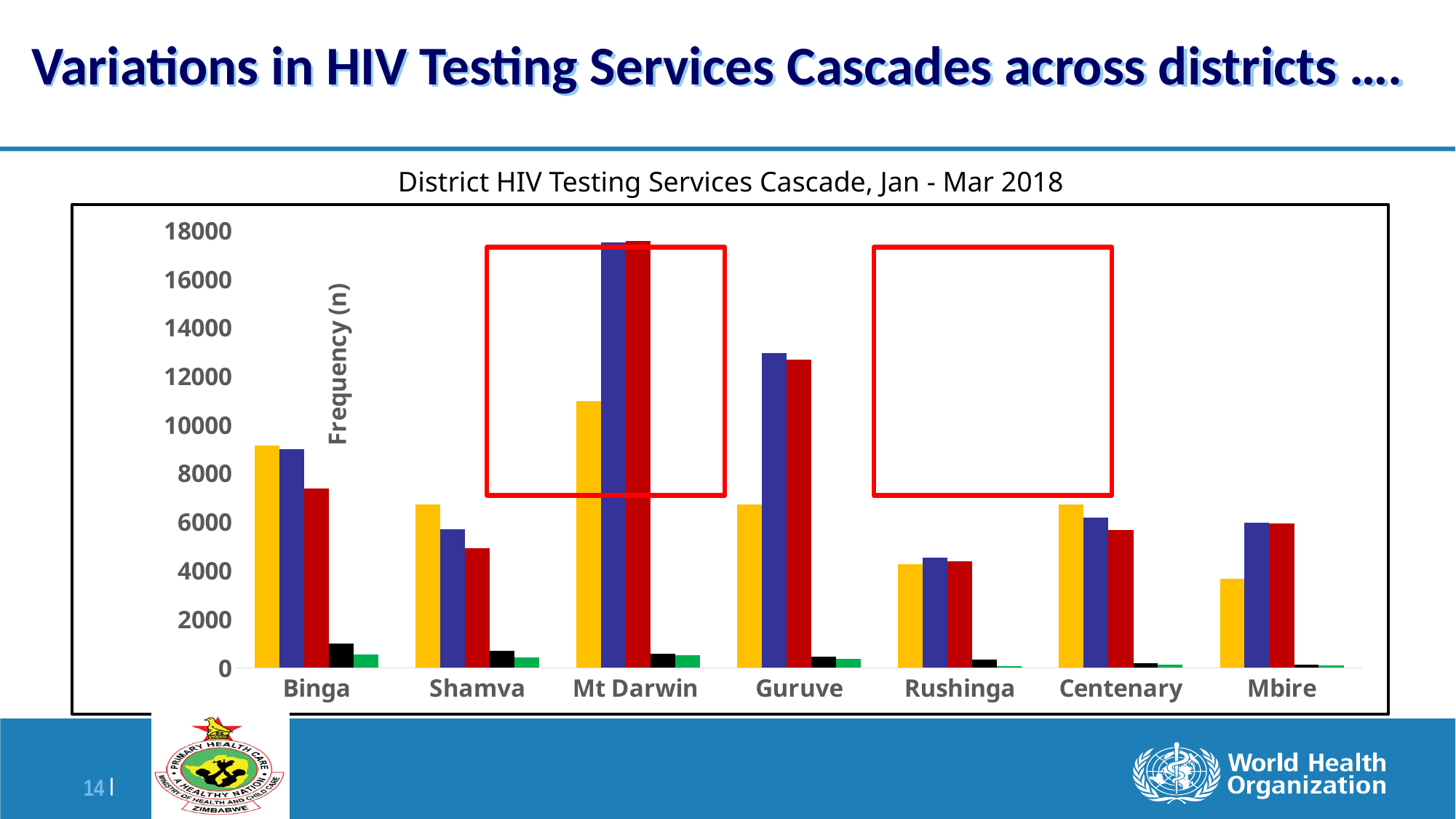
What kind of chart is shown on the slide? bar chart Which is larger, the yellow bar for Binga or the yellow bar for Mbire? Binga Which district has the lowest yellow bar? Mbire How many districts are shown on the x axis of the chart? 7 Is the yellow bar for Guruve greater or less than 8000? less Is the yellow bar for Binga greater or less than 8000? greater Which district has the tallest bar in the chart? Mt Darwin Is the blue bar for Mt Darwin greater or less than 16000? greater What is the label of the vertical axis? Frequency (n) Which is larger, the blue bar for Guruve or the blue bar for Centenary? Guruve What is the title of the chart? District HIV Testing Services Cascade, Jan - Mar 2018